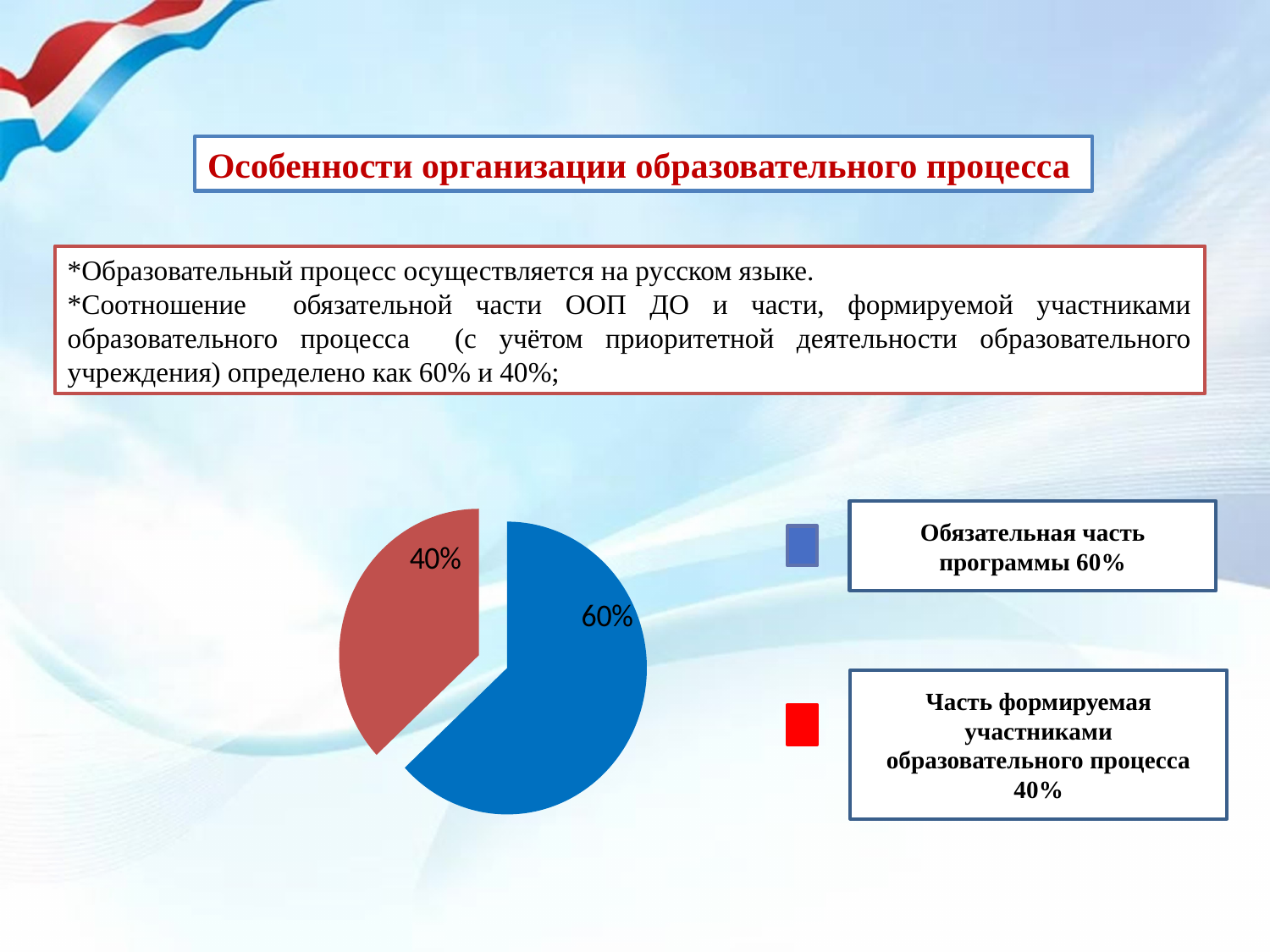
Which is larger: the share for Обязательная часть программы or the share for Часть формируемая участниками образовательного процесса? Обязательная часть программы How many slices does the pie chart have? 2 What colour is the slice representing Обязательная часть программы? blue What share of the pie does the red slice (Часть формируемая участниками образовательного процесса) represent? 40% What kind of chart is shown on the slide? pie chart What share of the pie does the blue slice (Обязательная часть программы) represent? 60% Which slice of the pie is the smallest? Часть формируемая участниками образовательного процесса What colour is the slice representing Часть формируемая участниками образовательного процесса? red What is the total of the two slices shown in the pie chart? 100% What is the difference in percentage points between the blue slice and the red slice? 20% Which slice of the pie is the largest? Обязательная часть программы